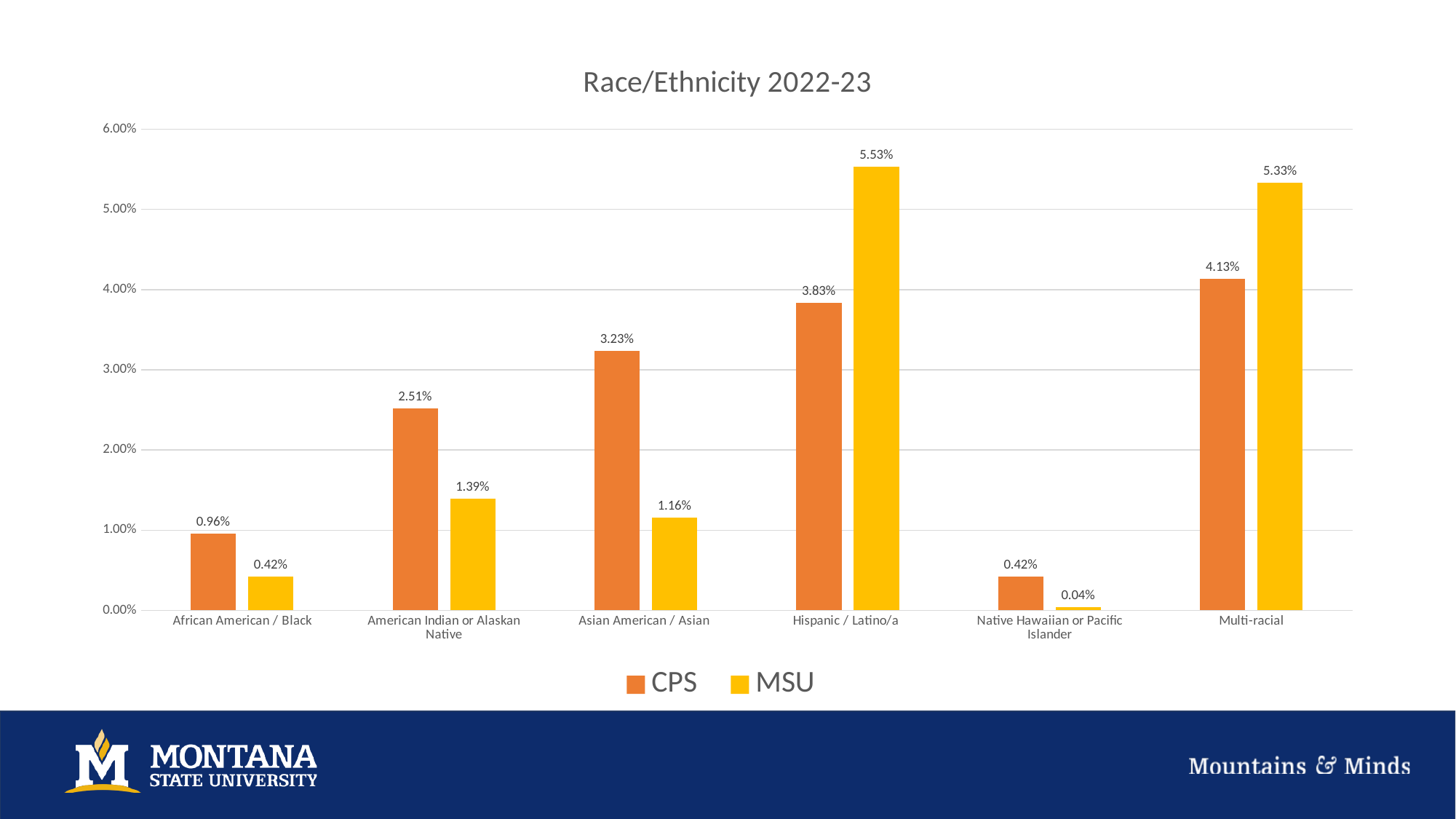
What is the MSU value for Native Hawaiian or Pacific Islander? 0.04% For Asian American / Asian, which is larger, the CPS value or the MSU value? CPS What is the MSU value for American Indian or Alaskan Native? 1.39% What is the difference between the MSU and CPS values for Multi-racial? 1.20% What is the title of the chart? Race/Ethnicity 2022-23 What is the CPS value for Hispanic / Latino/a? 3.83% How many series does the legend list? 2 How many race/ethnicity categories are shown on the x axis? 6 Is the CPS value for Multi-racial greater or less than 4.00%? greater Which category has the lowest CPS value? Native Hawaiian or Pacific Islander Which category has the highest MSU value? Hispanic / Latino/a What kind of chart is shown on the slide? Bar chart